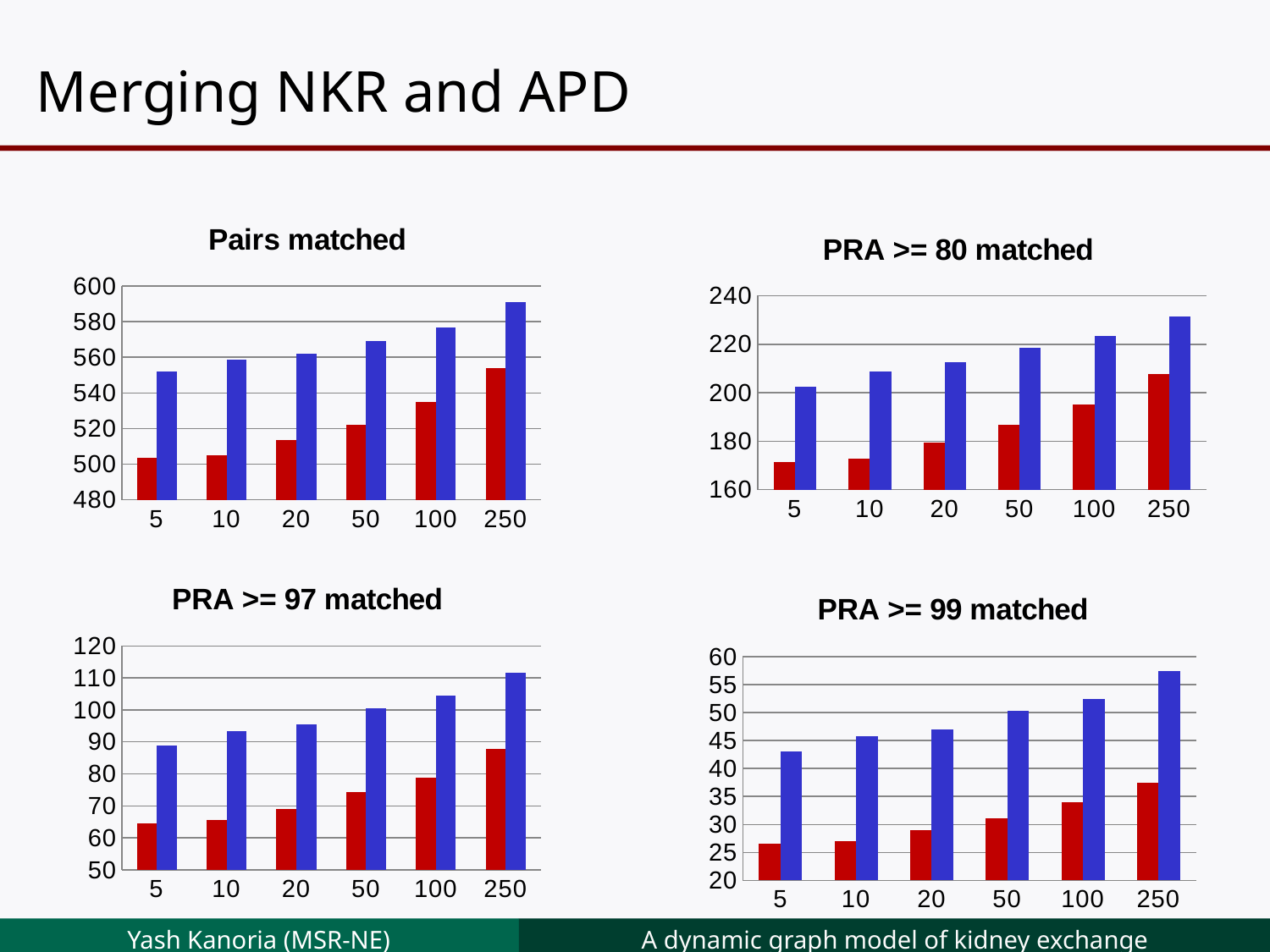
In the "PRA >= 97 matched" chart, is the red bar for 5 greater or less than 70? less In the "PRA >= 99 matched" chart, is the blue bar for 250 greater or less than 55? greater What kind of chart is the "Pairs matched" chart? bar chart In the "Pairs matched" chart, is the blue bar for 250 greater or less than 580? greater In the "Pairs matched" chart, do the blue bars rise or fall from 5 to 250 along the x axis? rise How many charts are shown on the slide? 4 How many categories are shown on the x axis of the "PRA >= 80 matched" chart? 6 In the "PRA >= 97 matched" chart, which category has the lowest red bar? 5 In the "PRA >= 99 matched" chart, which category has the highest blue bar? 250